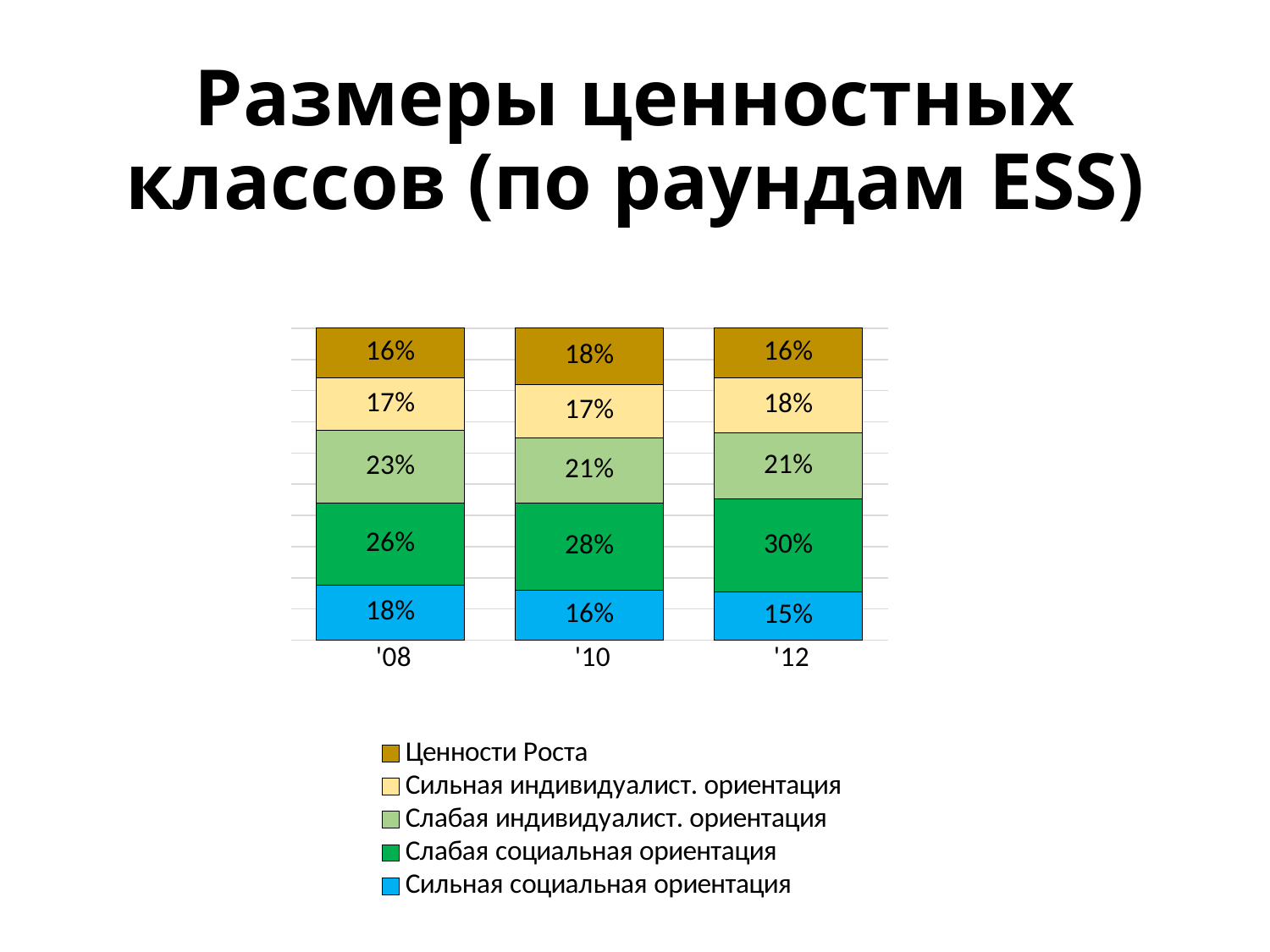
What kind of chart is shown on the slide? stacked bar chart What is the difference between Слабая социальная ориентация in '12 and in '08? 4% How many categories (ESS rounds) are shown on the x axis? 3 In which round is Слабая социальная ориентация highest? '12 What is the value for Ценности Роста in '10? 18% Does Слабая социальная ориентация rise or fall from '08 to '12? rise Which is larger: Сильная индивидуалист. ориентация in '12 or Ценности Роста in '12? Сильная индивидуалист. ориентация What is the value for Слабая индивидуалист. ориентация in '08? 23% How many series does the legend list? 5 In which round is Сильная социальная ориентация lowest? '12 What is the value for Слабая социальная ориентация in '12? 30% What is the value for Сильная социальная ориентация in '08? 18%